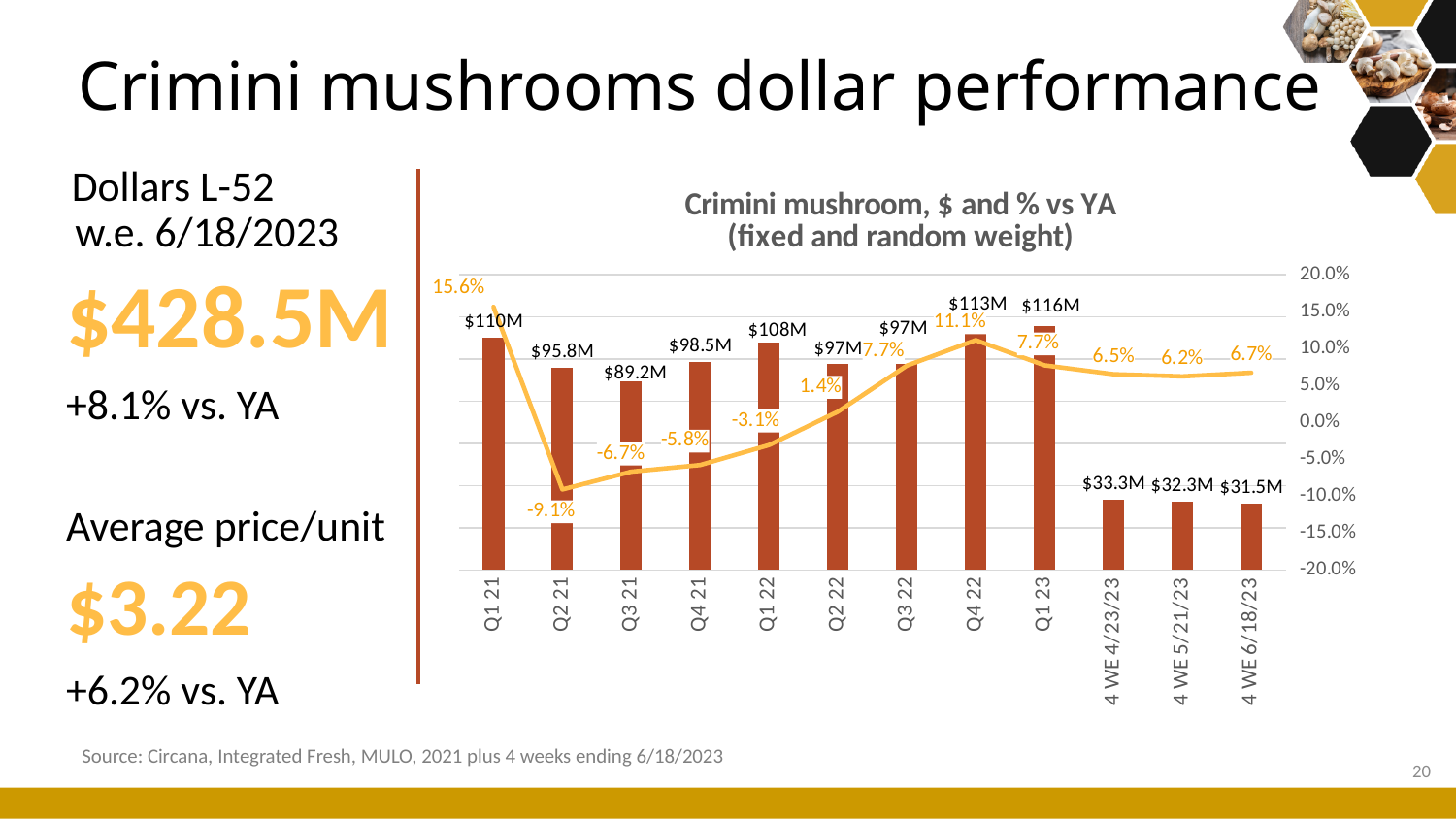
Which period has the lowest % vs YA value? Q2 21 What is the dollar value for 4 WE 6/18/23? $31.5M Does the % vs YA line rise or fall from Q2 21 to Q4 22? Rise Which has a larger dollar value, Q3 21 or Q4 21? Q4 21 What is the % vs YA value for Q4 22? 11.1% How many periods are shown on the x axis? 12 What is the difference in dollar value between Q1 23 and Q4 22? $3M What is the % vs YA value for Q2 21? -9.1% What kind of chart is this? Bar chart with a line Which period has the highest dollar value? Q1 23 What is the title of the chart? Crimini mushroom, $ and % vs YA (fixed and random weight) What is the dollar value for Q1 23? $116M